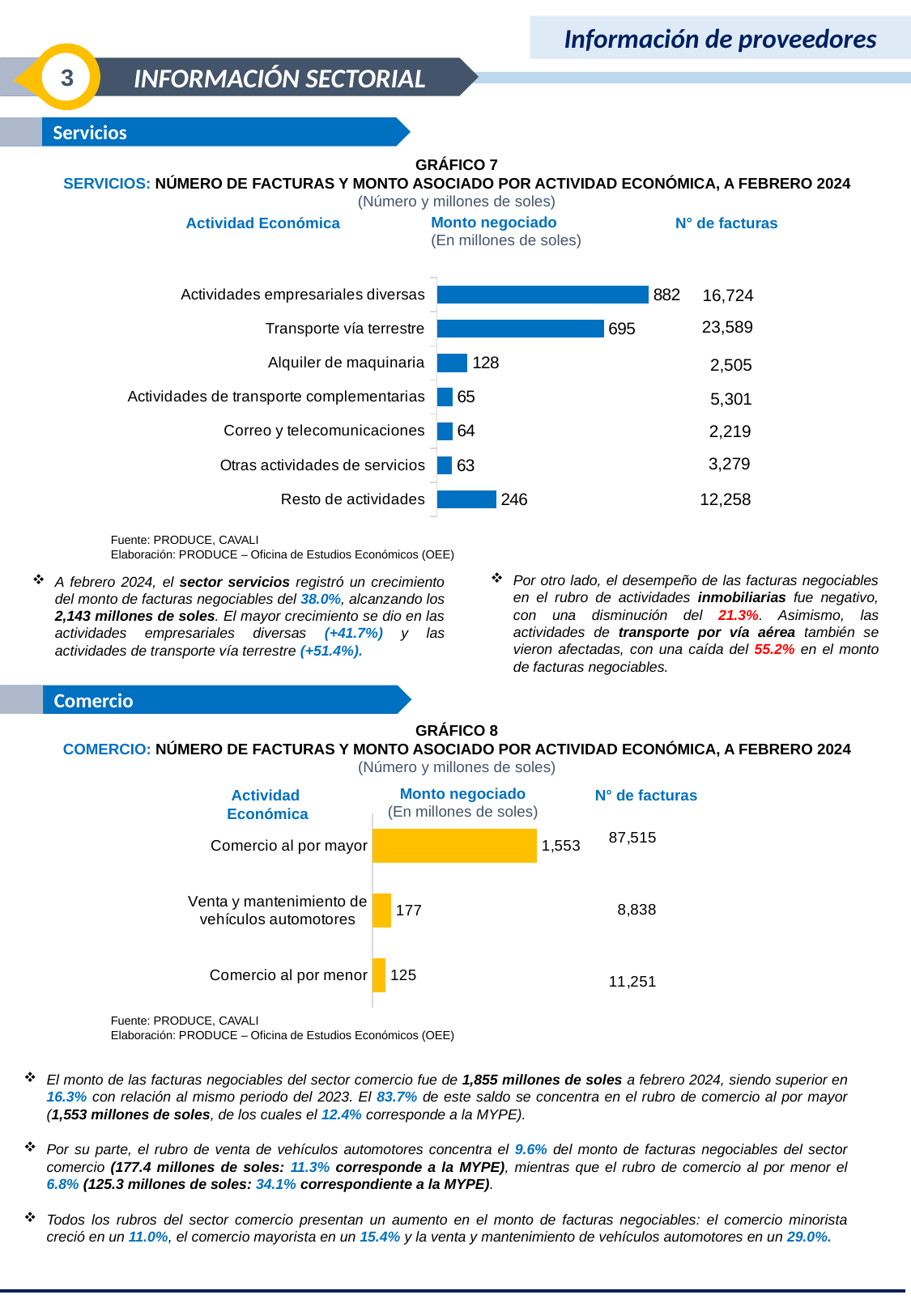
In Gráfico 8 (Comercio), what is the Monto negociado for Comercio al por mayor? 1,553 In Gráfico 7 (Servicios), which has a larger Monto negociado: Alquiler de maquinaria or Resto de actividades? Resto de actividades In Gráfico 8 (Comercio), what is the N° de facturas for Comercio al por menor? 11,251 In Gráfico 7 (Servicios), which activity has the highest Monto negociado? Actividades empresariales diversas In Gráfico 8 (Comercio), what is the difference in Monto negociado between Venta y mantenimiento de vehículos automotores and Comercio al por menor? 52 In Gráfico 7 (Servicios), what is the N° de facturas for Transporte vía terrestre? 23,589 What type of chart is Gráfico 8 (Comercio)? Bar chart In Gráfico 7 (Servicios), how many economic activities are shown? 7 In Gráfico 7 (Servicios), what is the difference in Monto negociado between Actividades empresariales diversas and Transporte vía terrestre? 187 In Gráfico 7 (Servicios), which activity has the lowest Monto negociado? Otras actividades de servicios In Gráfico 8 (Comercio), how many categories are shown? 3 In Gráfico 7 (Servicios), what is the Monto negociado for Actividades empresariales diversas? 882